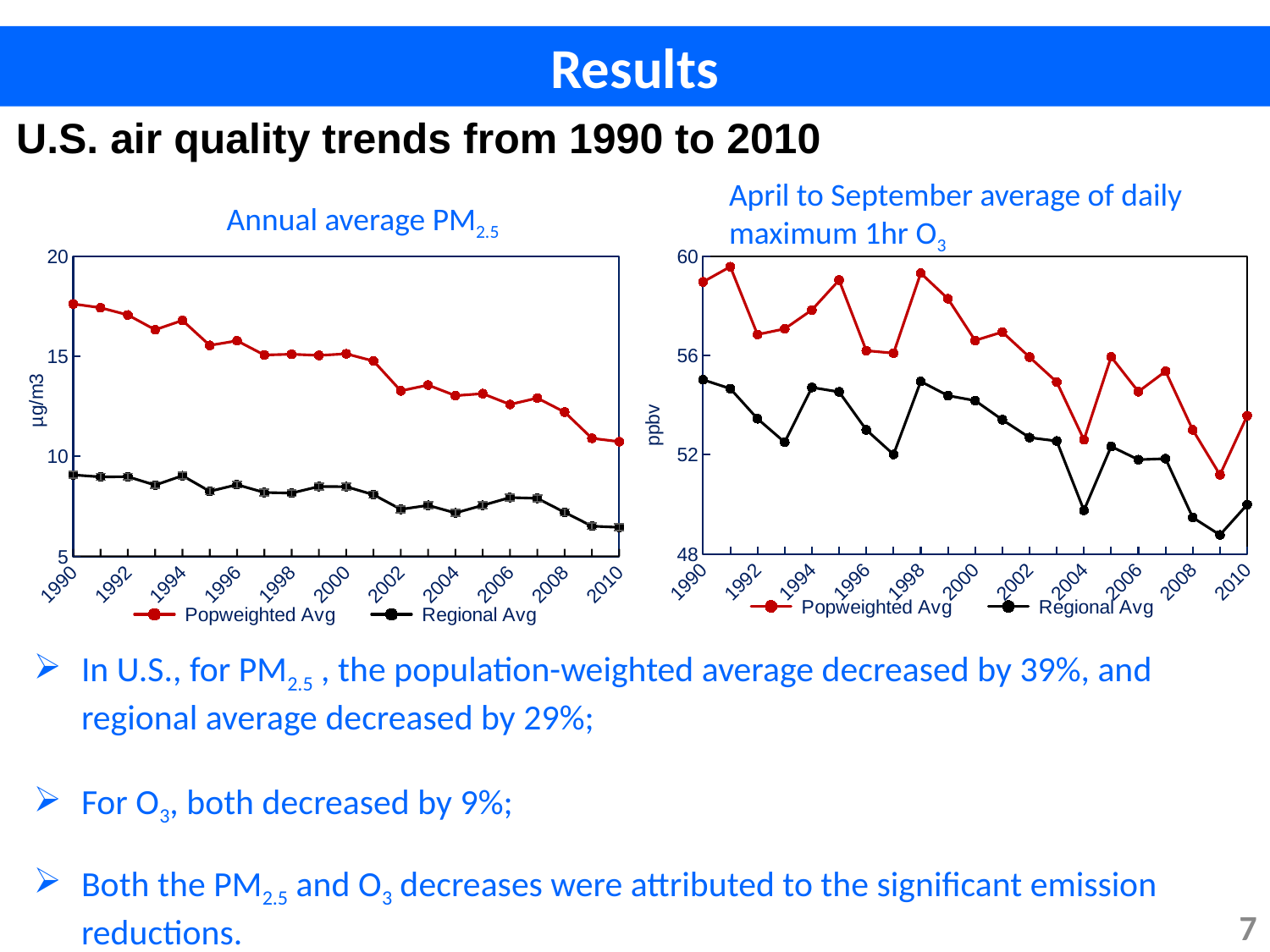
In the 'Annual average PM2.5' chart, is the Popweighted Avg value for 1990 greater or less than 15? greater In the 'Annual average PM2.5' chart, how many yearly data points are plotted for each series? 21 What is the y-axis label of the 'April to September average of daily maximum 1hr O3' chart? ppbv In the 'April to September average of daily maximum 1hr O3' chart, in which year is the Regional Avg lowest? 2009 In the 'April to September average of daily maximum 1hr O3' chart, is the Regional Avg value for 2010 greater or less than 52? less In the 'Annual average PM2.5' chart, which series has the larger value in 2000, Popweighted Avg or Regional Avg? Popweighted Avg In the 'Annual average PM2.5' chart, does the Popweighted Avg rise or fall from 1990 to 2010? fall What kind of chart is the 'April to September average of daily maximum 1hr O3' chart on the right? line chart In the 'April to September average of daily maximum 1hr O3' chart, is the Popweighted Avg value for 1990 greater or less than 56? greater In the 'Annual average PM2.5' chart, how many series does the legend list? 2 What kind of chart is the 'Annual average PM2.5' chart on the left? line chart